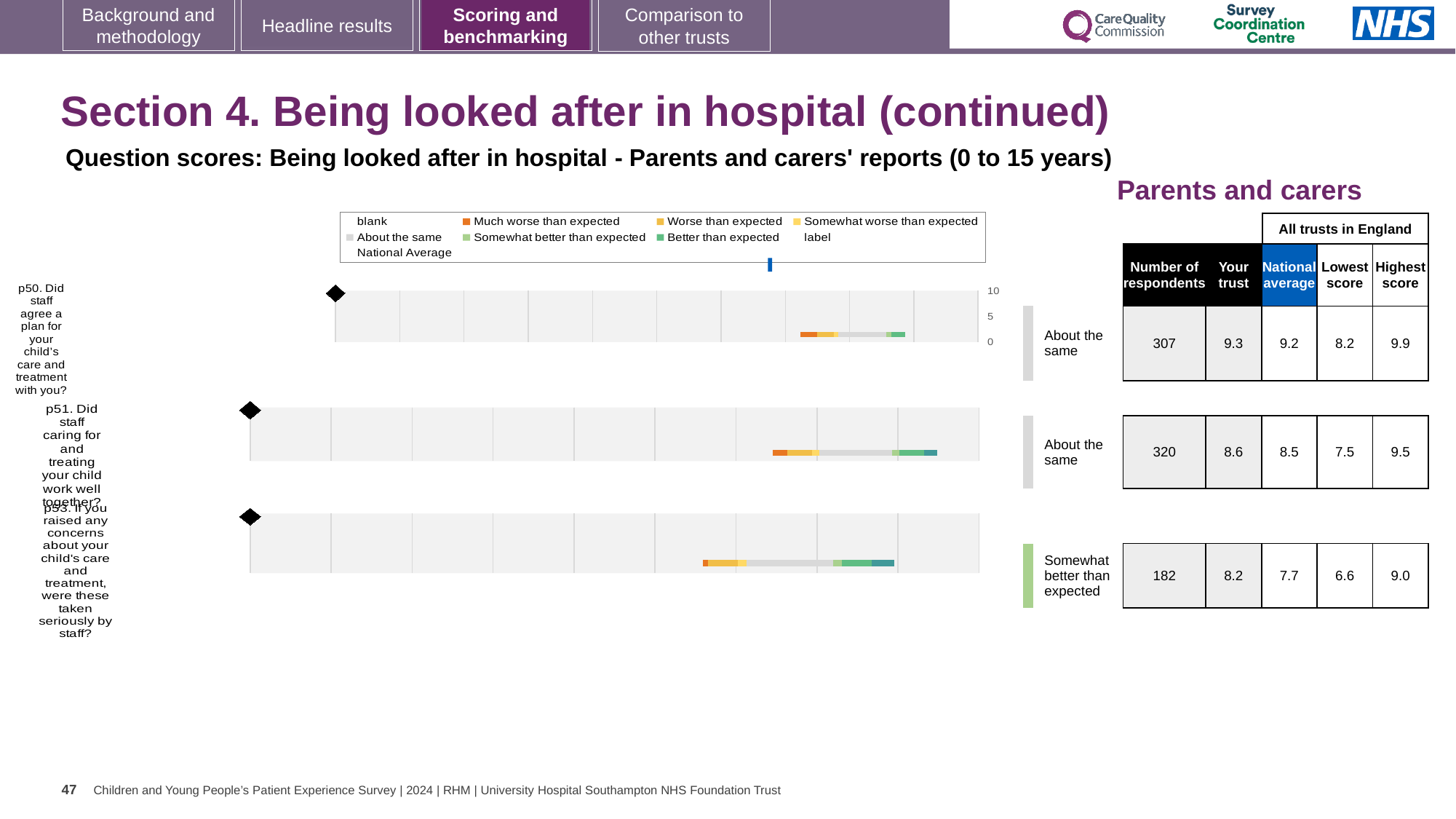
How many survey questions are plotted in the charts on this slide? 3 Which question has the highest 'Your trust' score? p50 How many respondents answered p53 (If you raised any concerns about your child's care and treatment, were these taken seriously by staff)? 182 What benchmark category is shown for p53? Somewhat better than expected Which question has the lowest national average score? p53 What is the national average score for p51 (Did staff caring for and treating your child work well together)? 8.5 For p51, which is larger: the 'Your trust' score or the national average? Your trust What is the 'Your trust' score for p50 (Did staff agree a plan for your child's care and treatment with you)? 9.3 What kind of chart is used to show the question scores on this slide? bar chart For p53, what is the difference between the 'Your trust' score and the national average? 0.5 For p50, what is the difference between the highest score and the lowest score among all trusts in England? 1.7 What is the highest score among all trusts in England for p50? 9.9